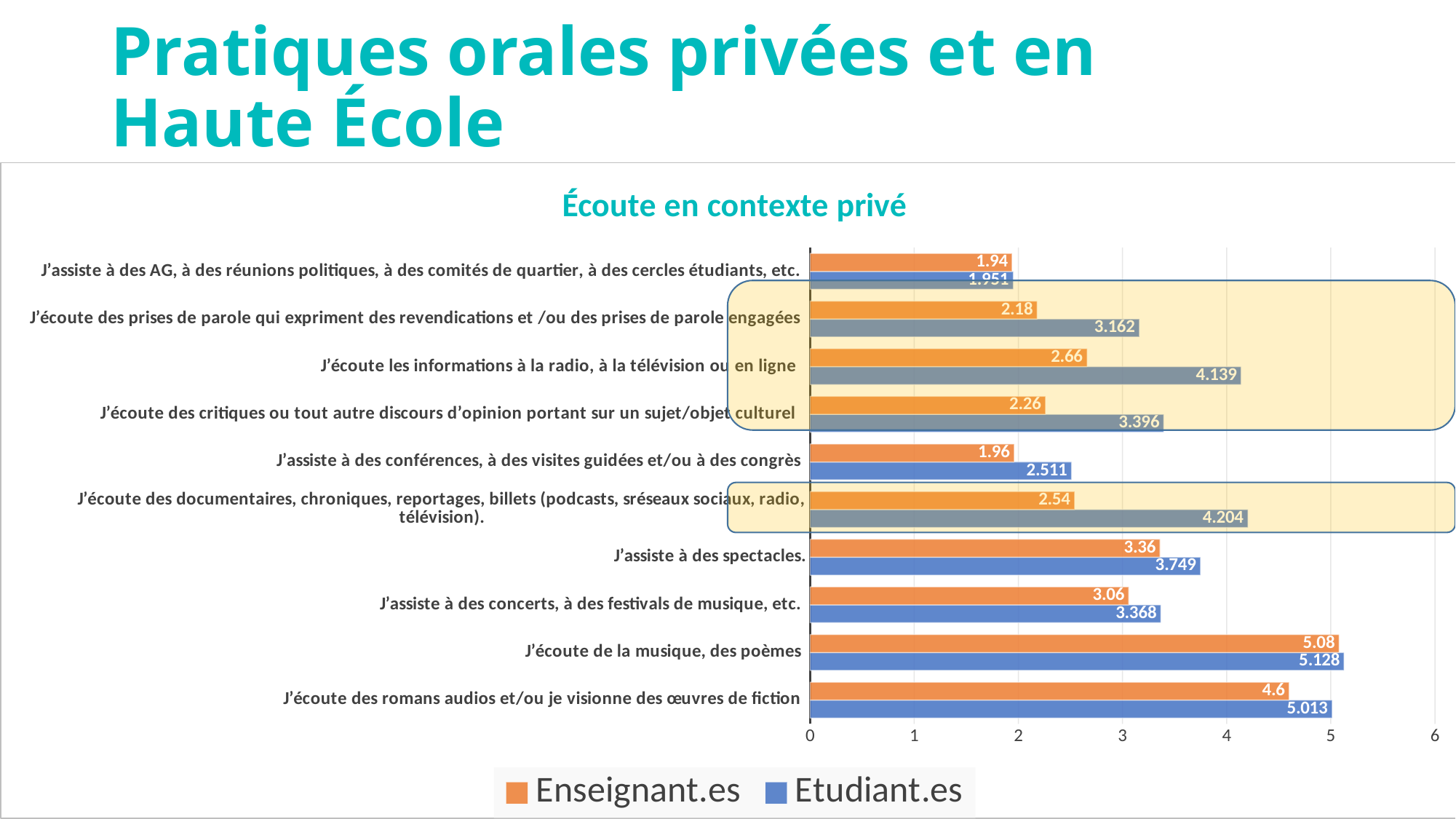
What is the Etudiant.es value for "J'écoute les informations à la radio, à la télévision ou en ligne"? 4.139 What type of chart is shown on the slide? bar chart What is the Etudiant.es value for "J'assiste à des conférences, à des visites guidées et/ou à des congrès"? 2.511 For "J'écoute des critiques ou tout autre discours d'opinion portant sur un sujet/objet culturel", which series has the larger value, Enseignant.es or Etudiant.es? Etudiant.es Is the Enseignant.es value for "J'écoute des romans audios et/ou je visionne des œuvres de fiction" greater or less than 4? greater How many categories are plotted in the chart? 10 Which category has the lowest Enseignant.es value? J'assiste à des AG, à des réunions politiques, à des comités de quartier, à des cercles étudiants, etc. What is the title of the chart? Écoute en contexte privé What is the difference between the Etudiant.es and Enseignant.es values for "J'écoute des documentaires, chroniques, reportages, billets (podcasts, sréseaux sociaux, radio, télévision)."? 1.664 Which category has the highest Etudiant.es value? J'écoute de la musique, des poèmes What is the Enseignant.es value for "J'écoute de la musique, des poèmes"? 5.08 How many series does the legend list? 2